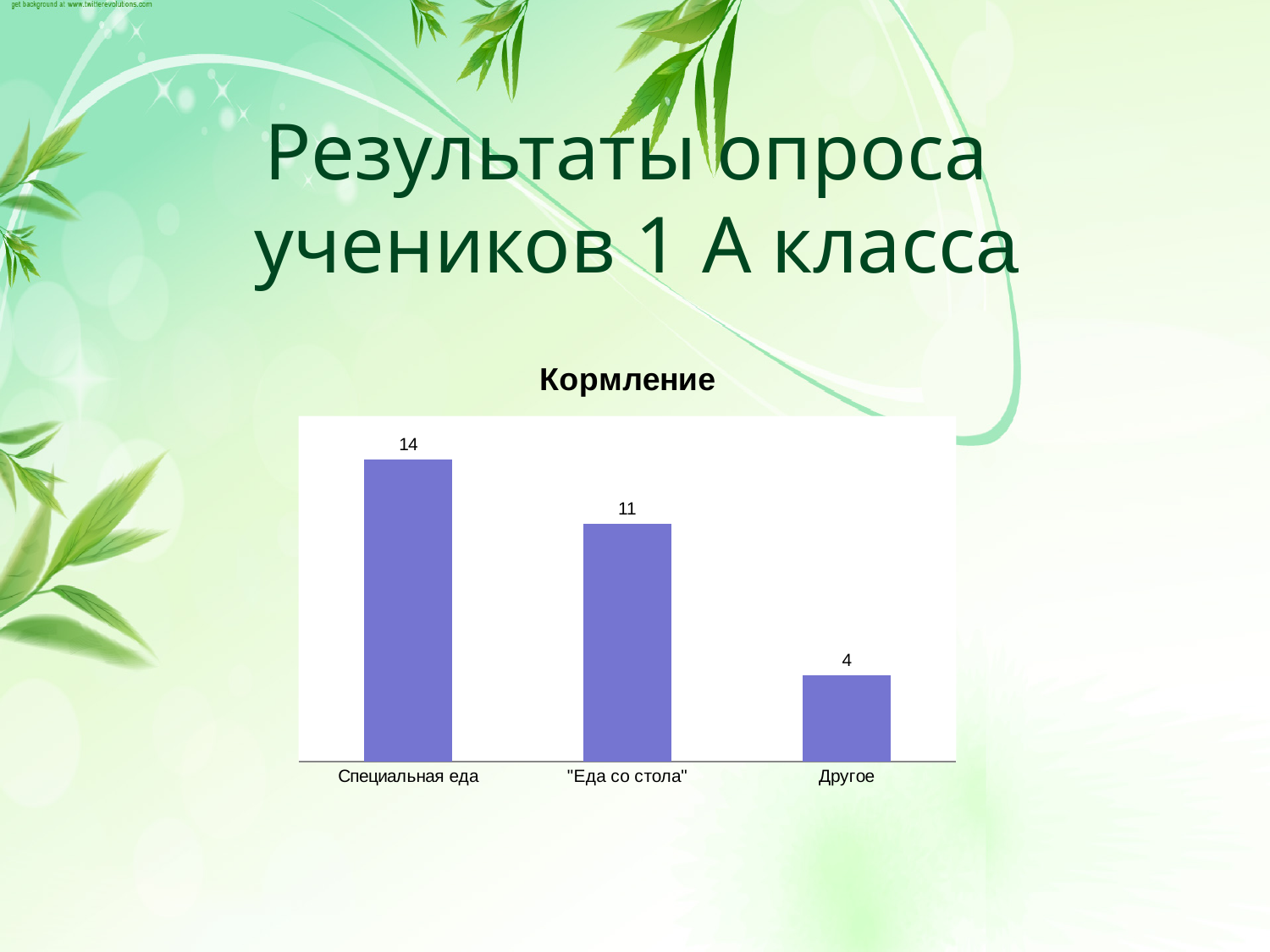
What is the value for "Еда со стола"? 11 Which is larger: the value for "Еда со стола" or the value for "Другое"? Еда со стола What is the value for "Специальная еда"? 14 What is the value for "Другое"? 4 Do the values rise or fall from left to right across the categories? fall What is the difference between the values for "Специальная еда" and "Еда со стола"? 3 What is the difference between the values for "Еда со стола" and "Другое"? 7 What kind of chart is shown on the slide? bar chart How many categories are shown in the chart? 3 Which category has the lowest value? Другое Which category has the highest value? Специальная еда What is the title of the chart? Кормление